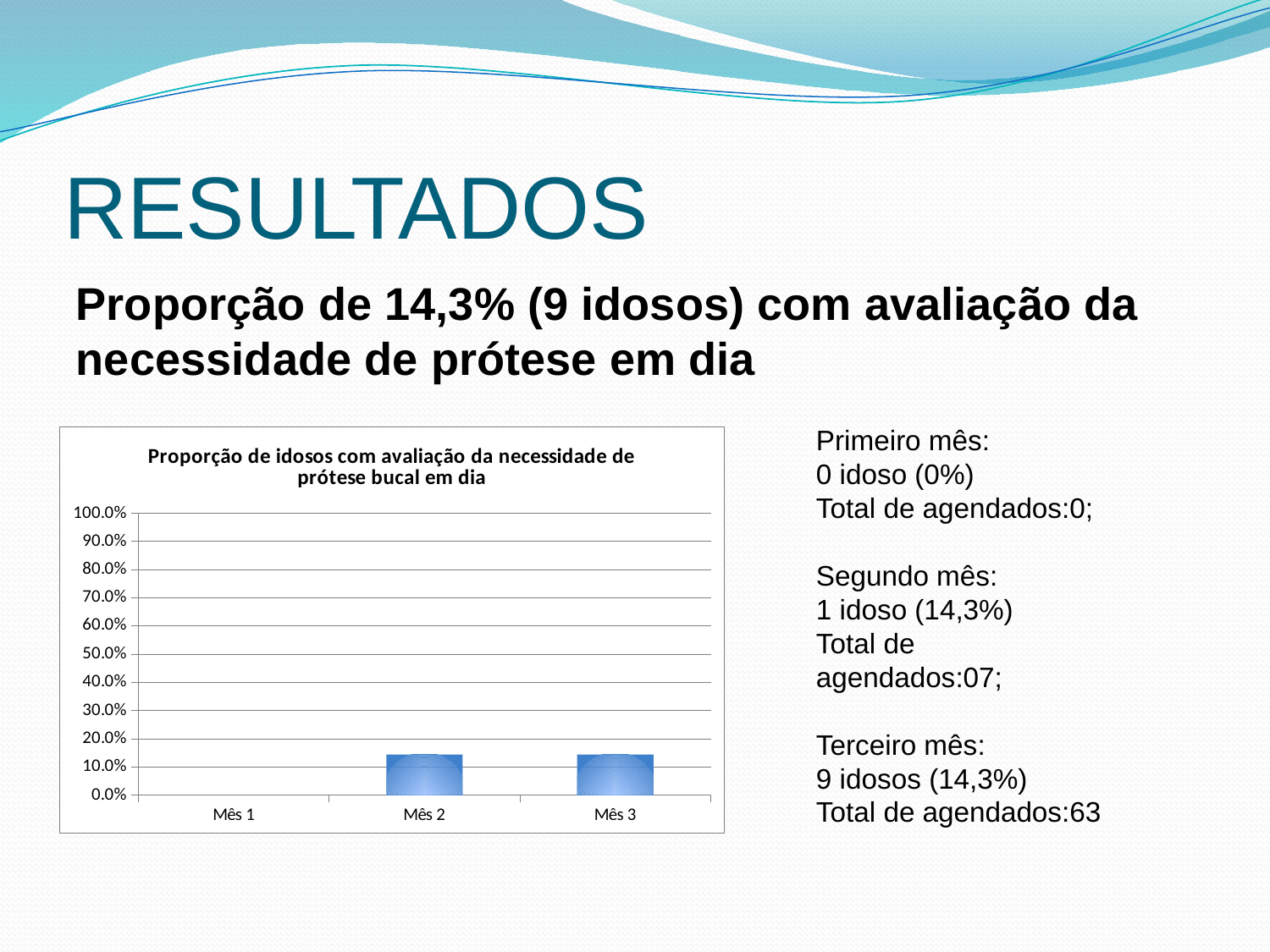
Is the value for Mês 3 greater or less than 50.0%? less What is the value for Mês 1 in the chart? 0.0% Is the value for Mês 2 greater or less than 10.0%? greater Which is larger, the value for Mês 1 or the value for Mês 2? Mês 2 What is the highest tick label on the y axis of the chart? 100.0% What kind of chart is shown on the slide? bar chart Is the value for Mês 2 greater or less than 20.0%? less What is the title of the chart? Proporção de idosos com avaliação da necessidade de prótese bucal em dia Which category has the lowest value in the chart? Mês 1 Does the value rise or fall from Mês 1 to Mês 2? rise How many categories are shown on the x axis of the chart? 3